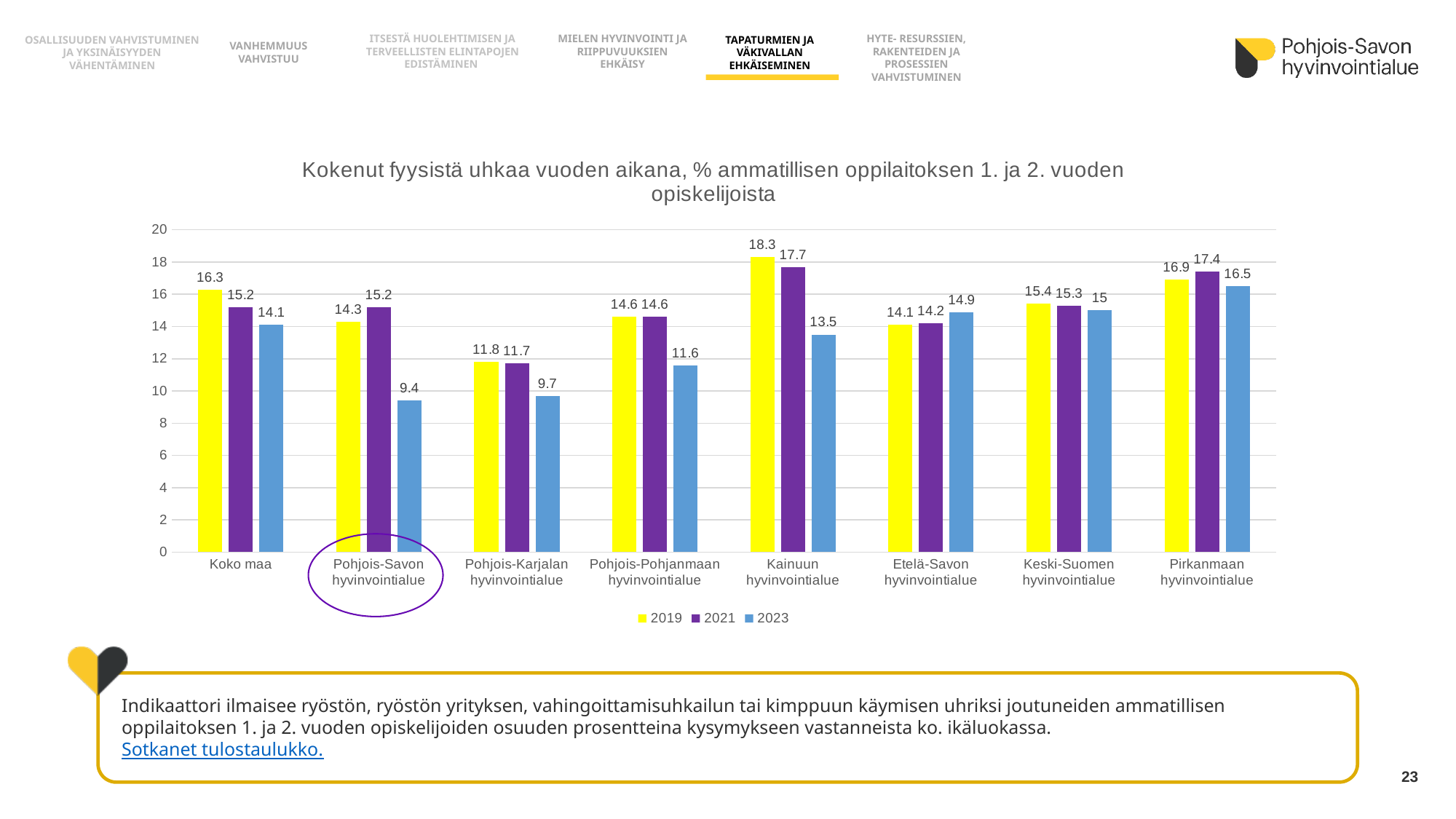
What is the 2019 value for Kainuun hyvinvointialue? 18.3 What is the 2021 value for Koko maa? 15.2 What is the difference between the 2019 and 2023 values for Pohjois-Savon hyvinvointialue? 4.9 What kind of chart is shown on the slide? Bar chart What is the 2023 value for Pohjois-Savon hyvinvointialue? 9.4 Which category has the lowest 2023 value? Pohjois-Savon hyvinvointialue Did the value for Pohjois-Karjalan hyvinvointialue rise or fall from 2019 to 2023? Fall Which category has the highest 2019 value? Kainuun hyvinvointialue How many categories are shown on the x axis? 8 Which series is shown in yellow in the legend? 2019 Which is larger for Etelä-Savon hyvinvointialue, the 2019 value or the 2023 value? 2023 How many series does the legend list? 3